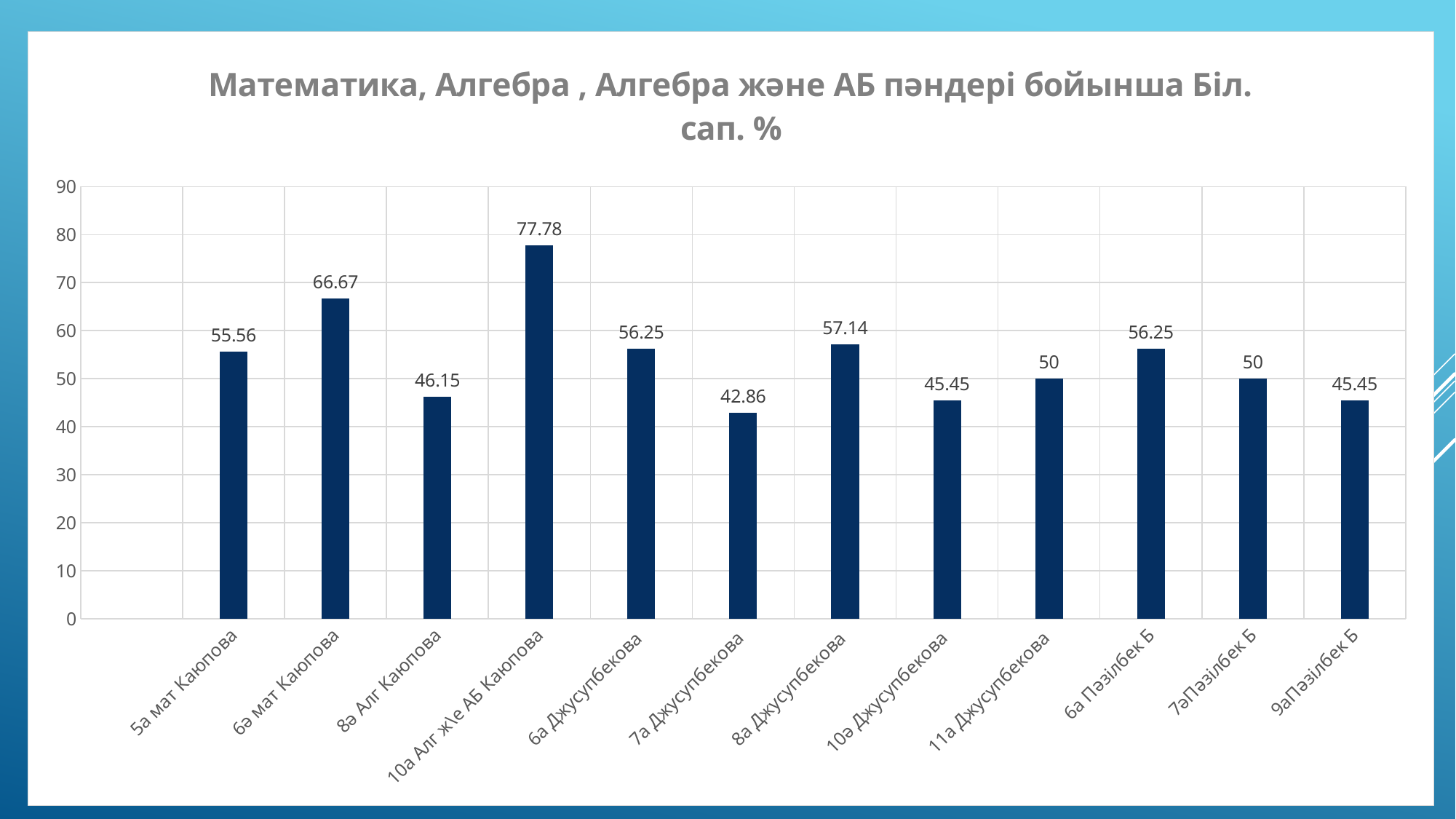
What is the value for 5а мат Каюпова? 55.56 What is the value for 11а Джусупбекова? 50 Is the value for 10а Алг ж\е АБ Каюпова greater or less than 70? greater What kind of chart is shown on the slide? bar chart Which category has the lowest value? 7а Джусупбекова What is the difference between the values for 6ә мат Каюпова and 8ә Алг Каюпова? 20.52 What is the value for 7а Джусупбекова? 42.86 Which is larger, the value for 6а Джусупбекова or the value for 10ә Джусупбекова? 6а Джусупбекова How many categories are shown on the x axis? 12 Which category has the highest value? 10а Алг ж\е АБ Каюпова What is the title of the chart? Математика, Алгебра , Алгебра және АБ пәндері бойынша Біл. сап. % What is the value for 8а Джусупбекова? 57.14